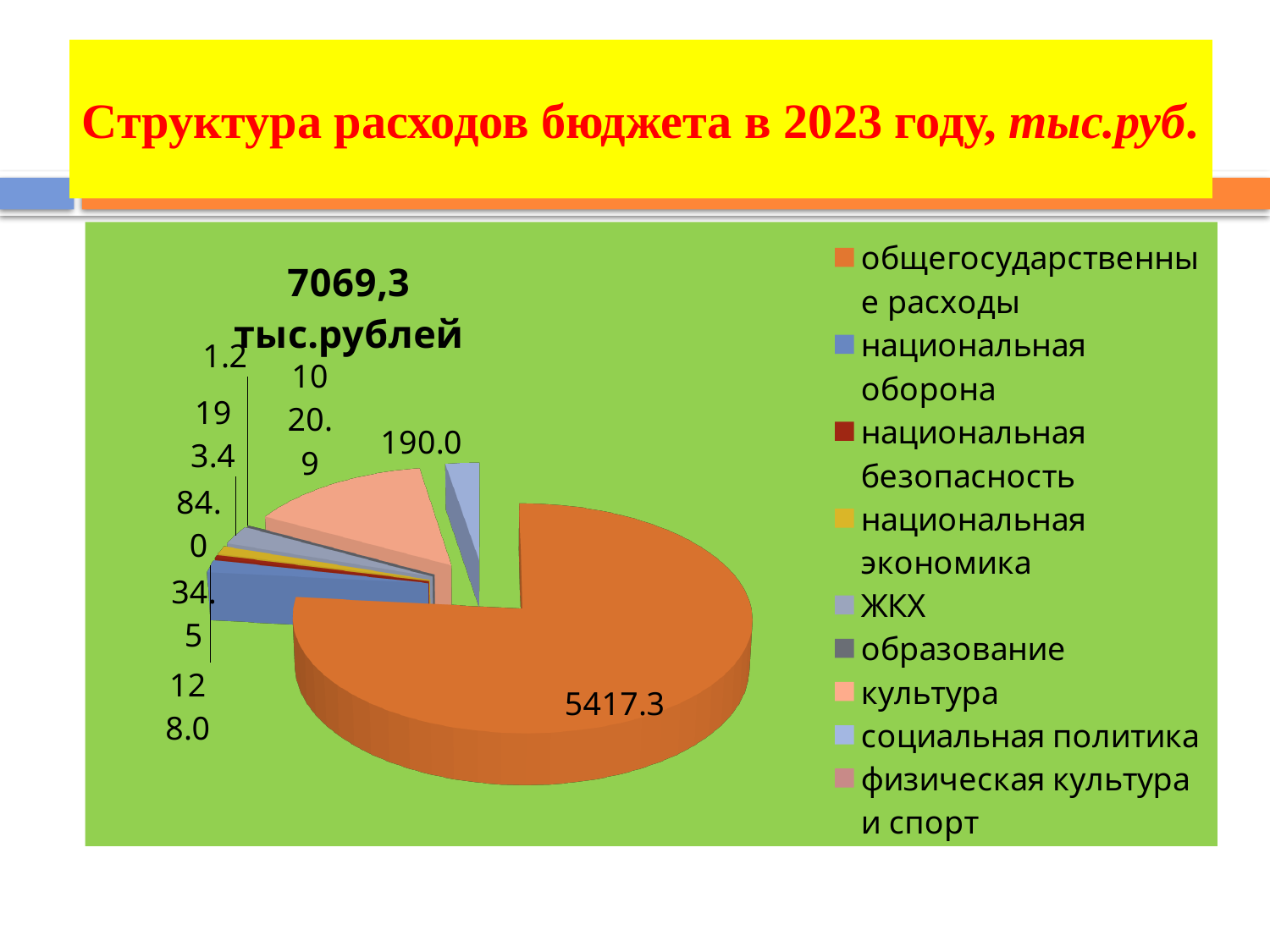
What is the title printed above the pie chart? 7069,3 тыс.рублей Which category has the largest slice of the pie? общегосударственные расходы Which is larger, the slice for общегосударственные расходы or the slice labelled 190.0? общегосударственные расходы What is the difference between the values for общегосударственные расходы and культура? 4396.4 Which is larger, the slice for общегосударственные расходы or the slice for культура? общегосударственные расходы What kind of chart is shown on the slide? pie chart What is the value shown for общегосударственные расходы? 5417.3 What is the value shown for культура? 1020.9 What is the title of the slide? Структура расходов бюджета в 2023 году, тыс.руб. How many categories does the legend list? 9